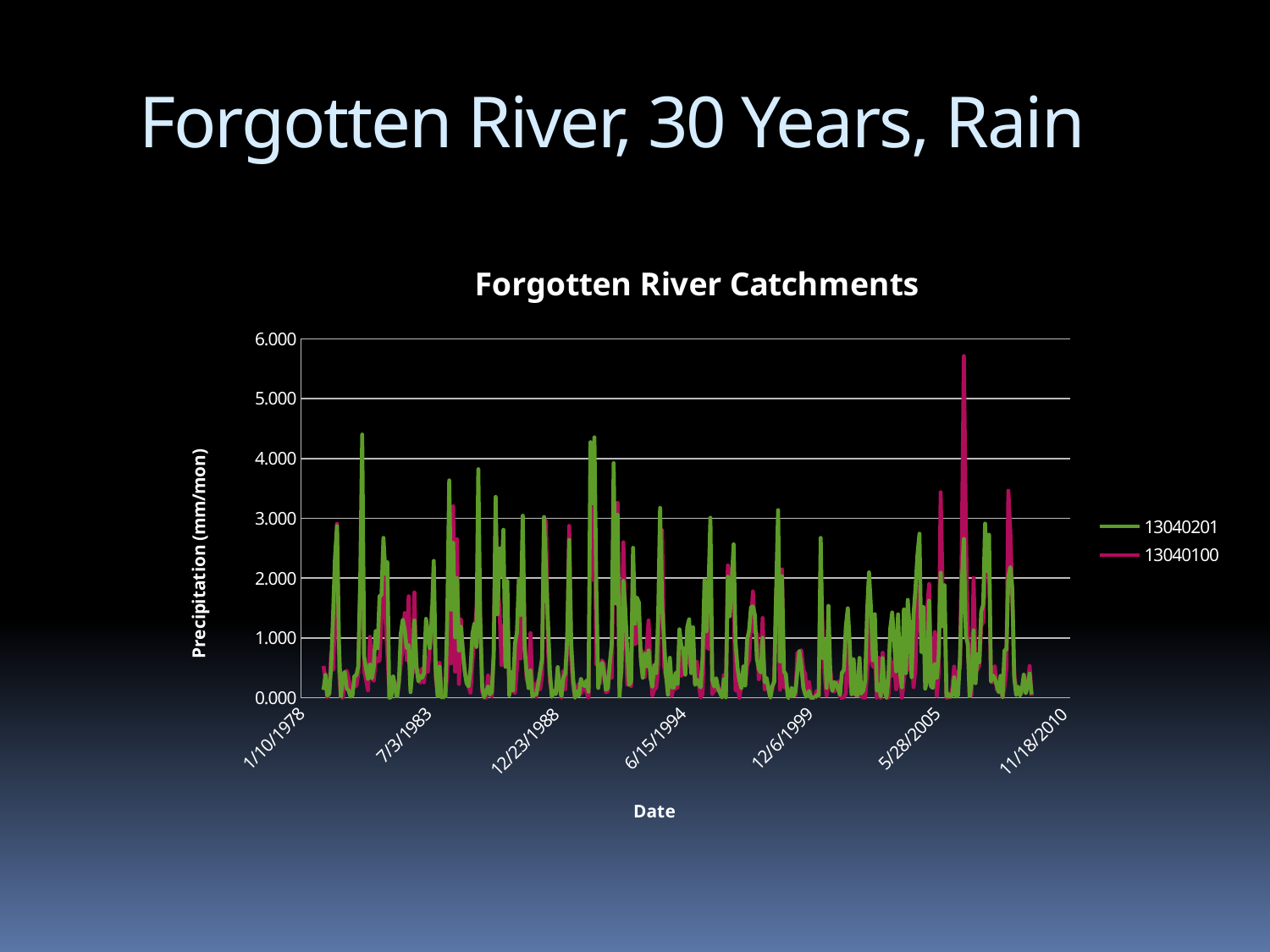
What type of chart is shown on the slide? line chart What is the last date label on the x axis? 11/18/2010 How many date labels are shown along the x axis? 7 What is the label of the vertical axis? Precipitation (mm/mon) Is the highest peak of series 13040201 greater or less than 5.000? less Which series reaches the highest peak on the chart, 13040201 or 13040100? 13040100 What is the highest value shown on the vertical axis? 6.000 How many series does the legend list? 2 What is the first date label on the x axis? 1/10/1978 Is the highest peak of series 13040201 greater or less than 4.000? greater What is the title of the chart? Forgotten River Catchments Is the highest peak of series 13040100 greater or less than 5.000? greater